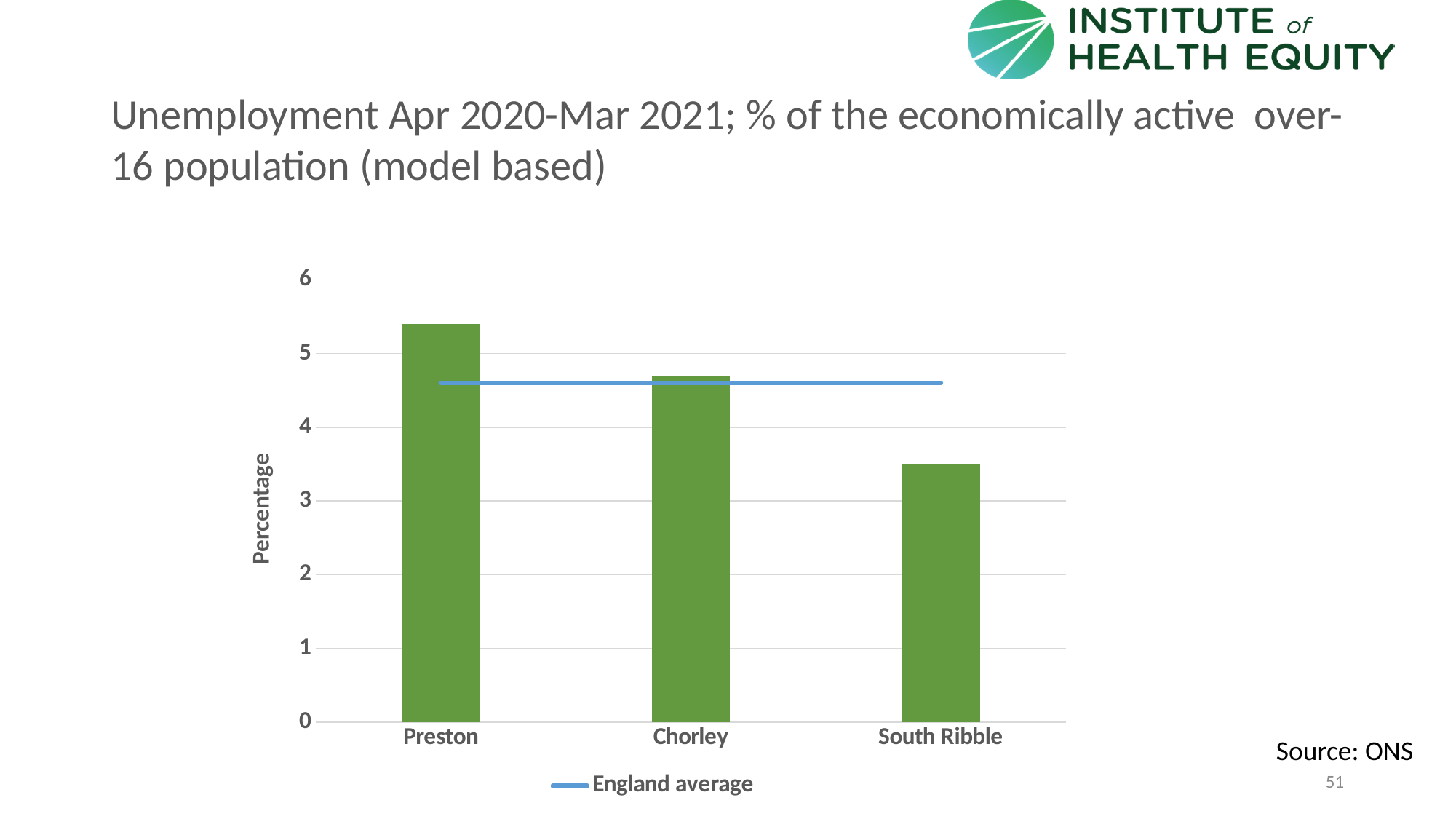
Do the bar values rise or fall from left to right across the x axis? fall What kind of chart is shown on the slide? bar chart Is the value for South Ribble greater or less than 4? less Which is larger, the value for Preston or the value for Chorley? Preston Which area has the highest unemployment percentage in the chart? Preston Is the value for Chorley greater or less than 4? greater Is the value for Preston greater or less than 6? less Which area has the lowest unemployment percentage in the chart? South Ribble Is the bar for South Ribble above or below the England average line? below How many areas (categories) are shown on the x axis of the chart? 3 What does the blue horizontal line in the chart represent, according to the legend? England average